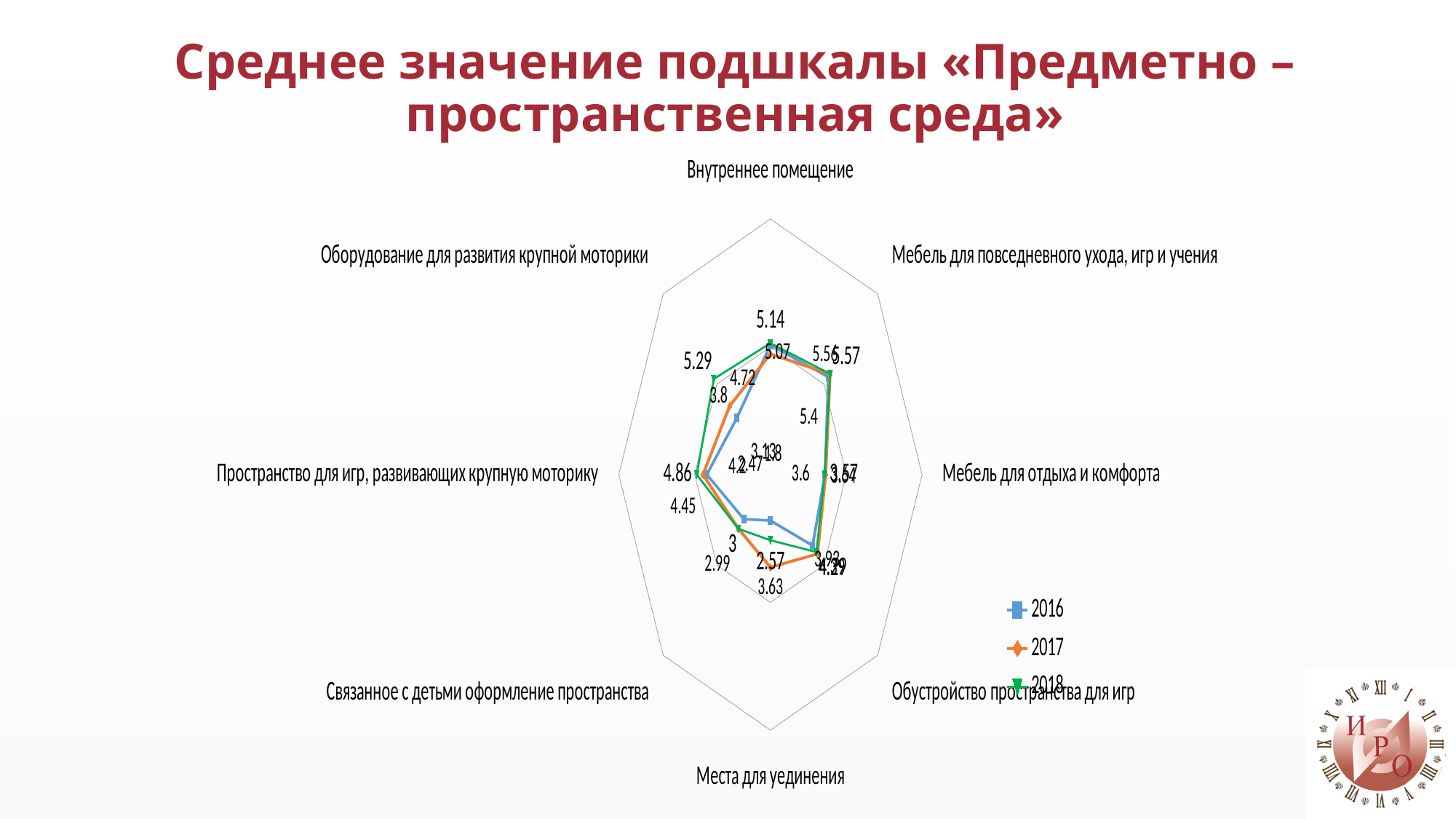
Which category has higher values: «Мебель для повседневного ухода, игр и учения» or «Мебель для отдыха и комфорта»? Мебель для повседневного ухода, игр и учения How many series does the legend list? 3 Which category has the highest values across all years? Мебель для повседневного ухода, игр и учения What is the difference between the 2018 values for «Оборудование для развития крупной моторики» and «Внутреннее помещение»? 0.15 Which years are listed in the chart legend? 2016, 2017, 2018 What type of chart is shown on the slide? Radar chart Which is larger in 2018: the value for «Оборудование для развития крупной моторики» or for «Внутреннее помещение»? Оборудование для развития крупной моторики What is the title of the slide? Среднее значение подшкалы «Предметно – пространственная среда» How many categories (axes) does the radar chart have? 8 What is the 2018 value for «Внутреннее помещение»? 5.14 What is the 2018 value for «Оборудование для развития крупной моторики»? 5.29